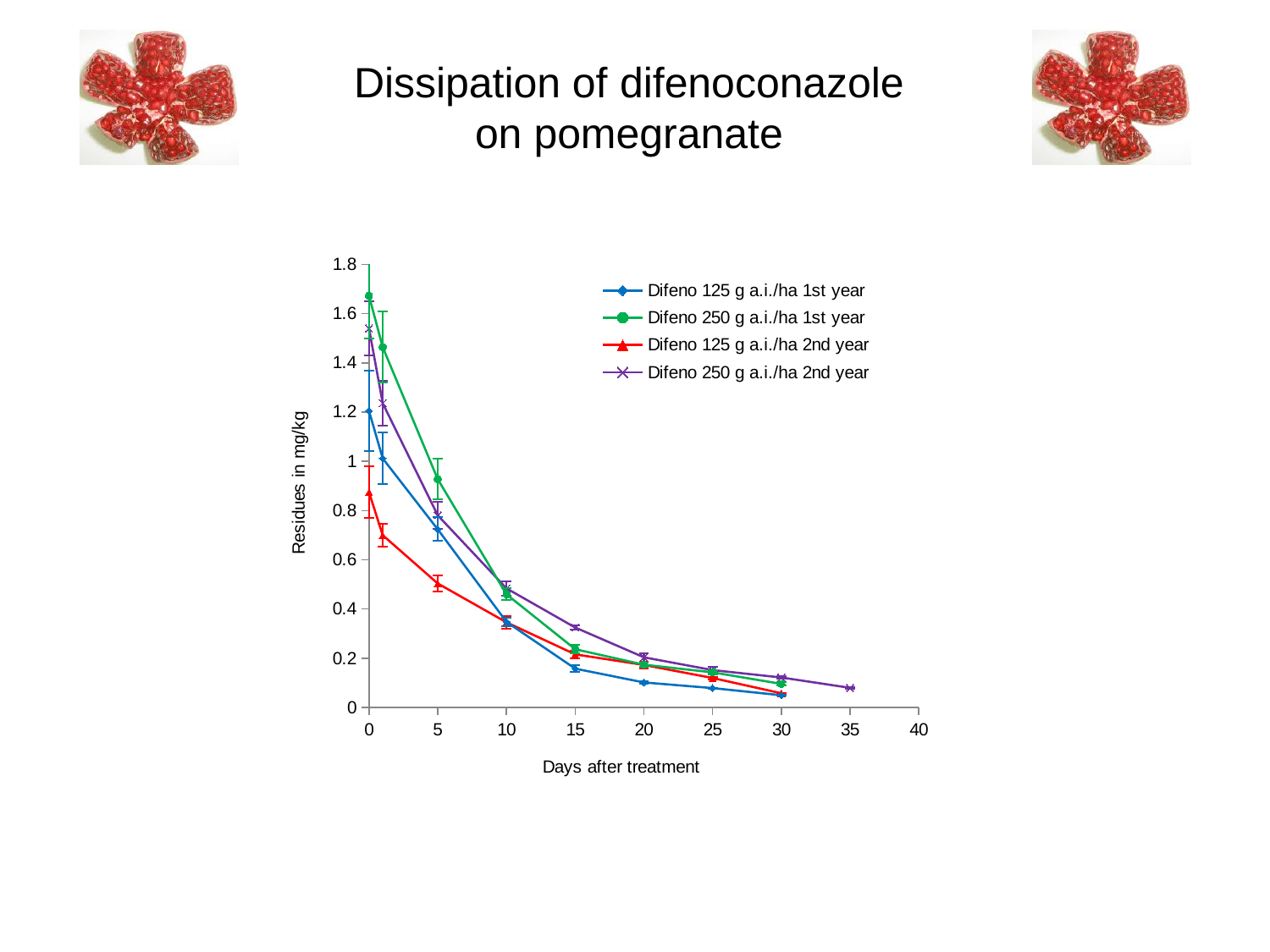
What is the label of the y axis? Residues in mg/kg Do the residue values rise or fall as days after treatment increase? fall At day 0, which is larger: Difeno 125 g a.i./ha 1st year or Difeno 125 g a.i./ha 2nd year? Difeno 125 g a.i./ha 1st year Which series has the lowest residue value at day 0? Difeno 125 g a.i./ha 2nd year How many series does the legend list? 4 What is the title of the chart? Dissipation of difenoconazole on pomegranate Is the value for Difeno 125 g a.i./ha 1st year at day 0 greater or less than 1? greater What kind of chart is shown on the slide? line chart Which series has the highest residue value at day 0? Difeno 250 g a.i./ha 1st year Is the value for Difeno 250 g a.i./ha 2nd year at day 15 greater or less than 0.2? greater At day 5, which is larger: Difeno 250 g a.i./ha 1st year or Difeno 125 g a.i./ha 2nd year? Difeno 250 g a.i./ha 1st year Is the value for Difeno 125 g a.i./ha 2nd year at day 5 greater or less than 0.6? less